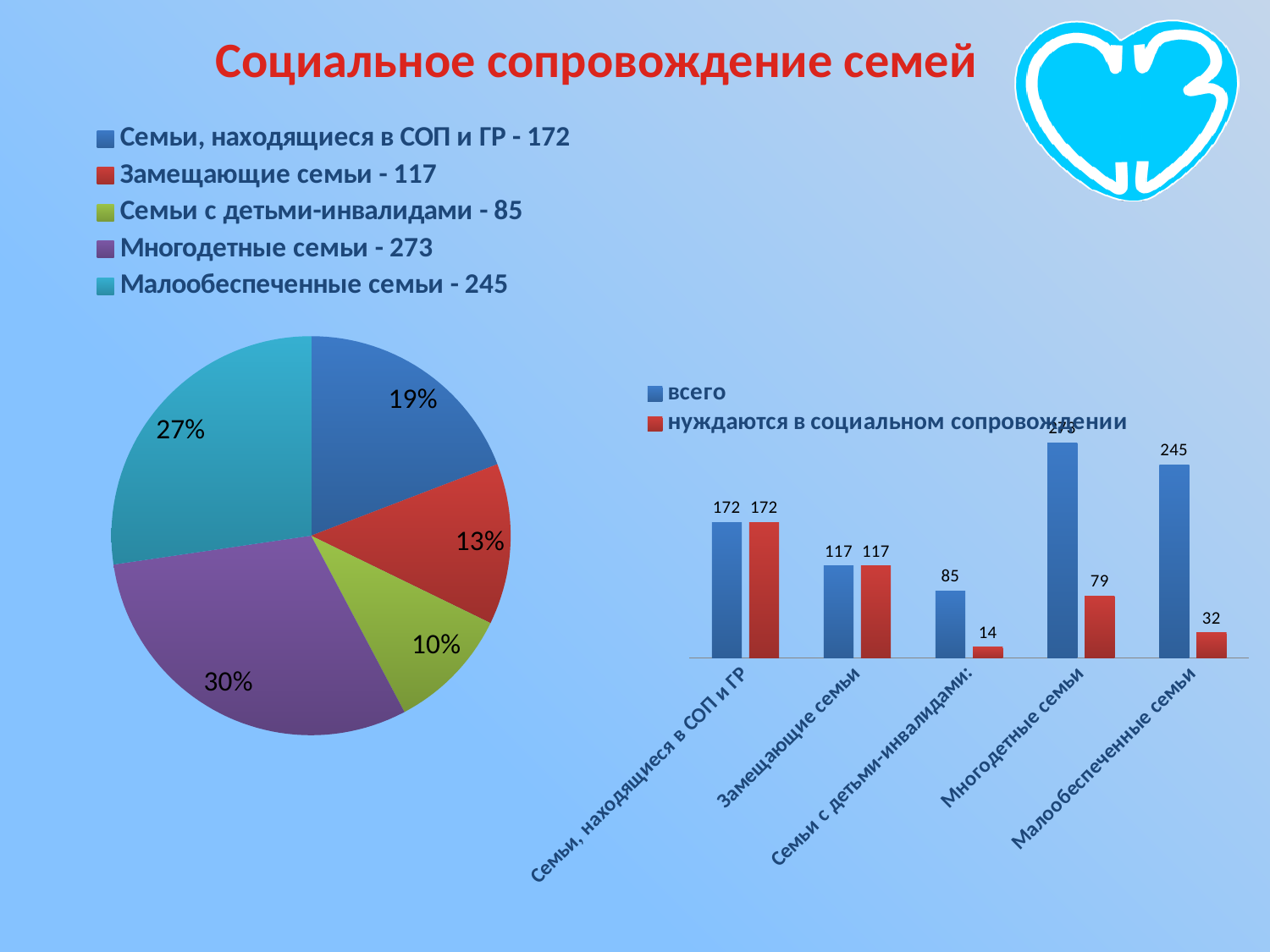
In the pie chart, what share is shown for Многодетные семьи? 30% In the bar chart, what is the difference between 'всего' and 'нуждаются в социальном сопровождении' for Многодетные семьи? 194 In the pie chart, what share is shown for Семьи с детьми-инвалидами? 10% In the pie chart, which category has the smallest slice? Семьи с детьми-инвалидами What type of chart is on the left side of the slide? pie chart In the bar chart, which is larger for Замещающие семьи: 'всего' or 'нуждаются в социальном сопровождении'? They are equal (117) In the bar chart, what is the value of 'нуждаются в социальном сопровождении' for Семьи с детьми-инвалидами? 14 How many series does the bar chart legend list? 2 In the pie chart, which category has the largest slice? Многодетные семьи How many categories does the pie chart legend list? 5 What type of chart is on the right side of the slide? bar chart In the bar chart, what is the value of 'нуждаются в социальном сопровождении' for Малообеспеченные семьи? 32